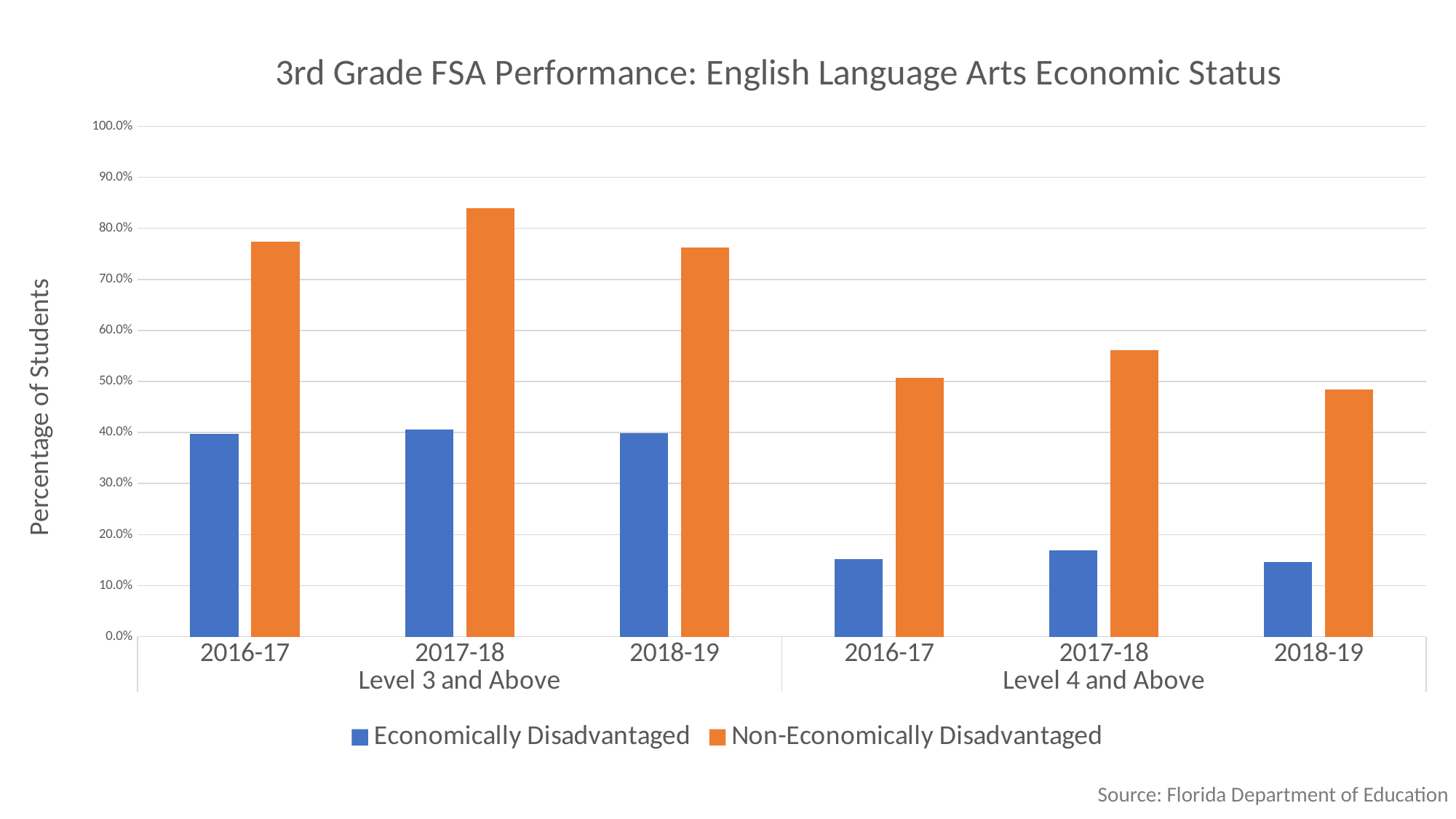
How many series does the legend list? 2 What is the source cited for the chart? Florida Department of Education Is the Non-Economically Disadvantaged value for 2017-18 in Level 4 and Above greater or less than 50.0%? greater Is the Non-Economically Disadvantaged value for 2016-17 in Level 4 and Above greater or less than 60.0%? less What kind of chart is shown on the slide? bar chart Is the Non-Economically Disadvantaged value for 2017-18 in Level 3 and Above greater or less than 80.0%? greater For 2016-17 in Level 3 and Above, which series has the larger value? Non-Economically Disadvantaged How many year categories are shown along the x axis in total? 6 Among the Level 4 and Above years, which year has the highest Non-Economically Disadvantaged value? 2017-18 Which bar is the highest on the chart? Non-Economically Disadvantaged, 2017-18, Level 3 and Above